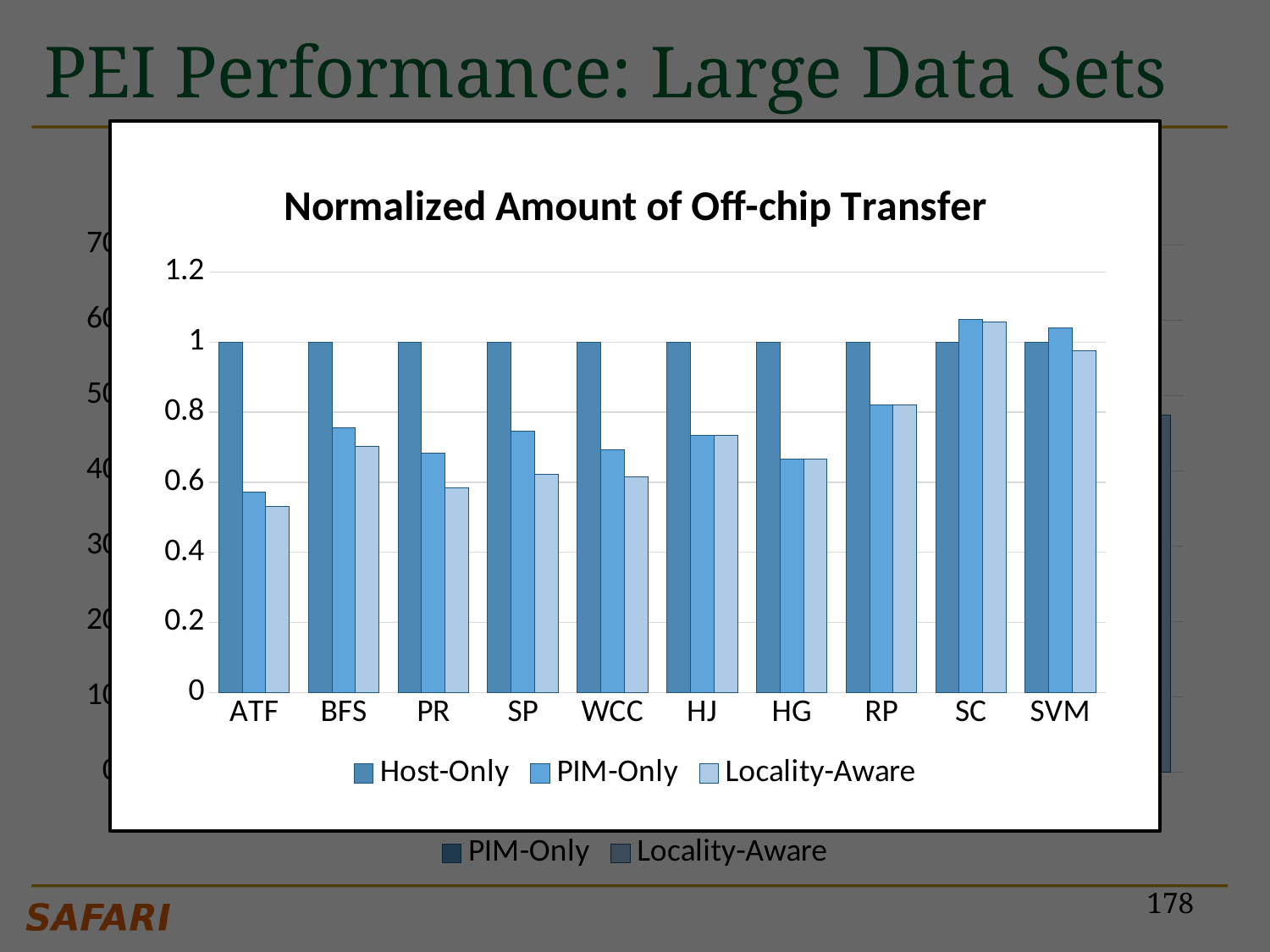
In the 'Normalized Amount of Off-chip Transfer' chart, which category has the lowest Locality-Aware value? ATF What are the three legend entries of the 'Normalized Amount of Off-chip Transfer' chart? Host-Only, PIM-Only, Locality-Aware In the 'Normalized Amount of Off-chip Transfer' chart, what is the Host-Only value for BFS? 1 In the 'Normalized Amount of Off-chip Transfer' chart, which is larger: the PIM-Only value for SC or the PIM-Only value for ATF? SC In the 'Normalized Amount of Off-chip Transfer' chart, is the PIM-Only value for SC greater or less than 1? greater How many series does the legend of the 'Normalized Amount of Off-chip Transfer' chart list? 3 In the 'Normalized Amount of Off-chip Transfer' chart, which category has the highest Locality-Aware value? SC In the 'Normalized Amount of Off-chip Transfer' chart, is the Locality-Aware value for RP greater or less than 0.6? greater How many categories are shown on the x axis of the 'Normalized Amount of Off-chip Transfer' chart? 10 In the 'Normalized Amount of Off-chip Transfer' chart, is the PIM-Only value for HG greater or less than 0.8? less What kind of chart is the 'Normalized Amount of Off-chip Transfer' chart? bar chart